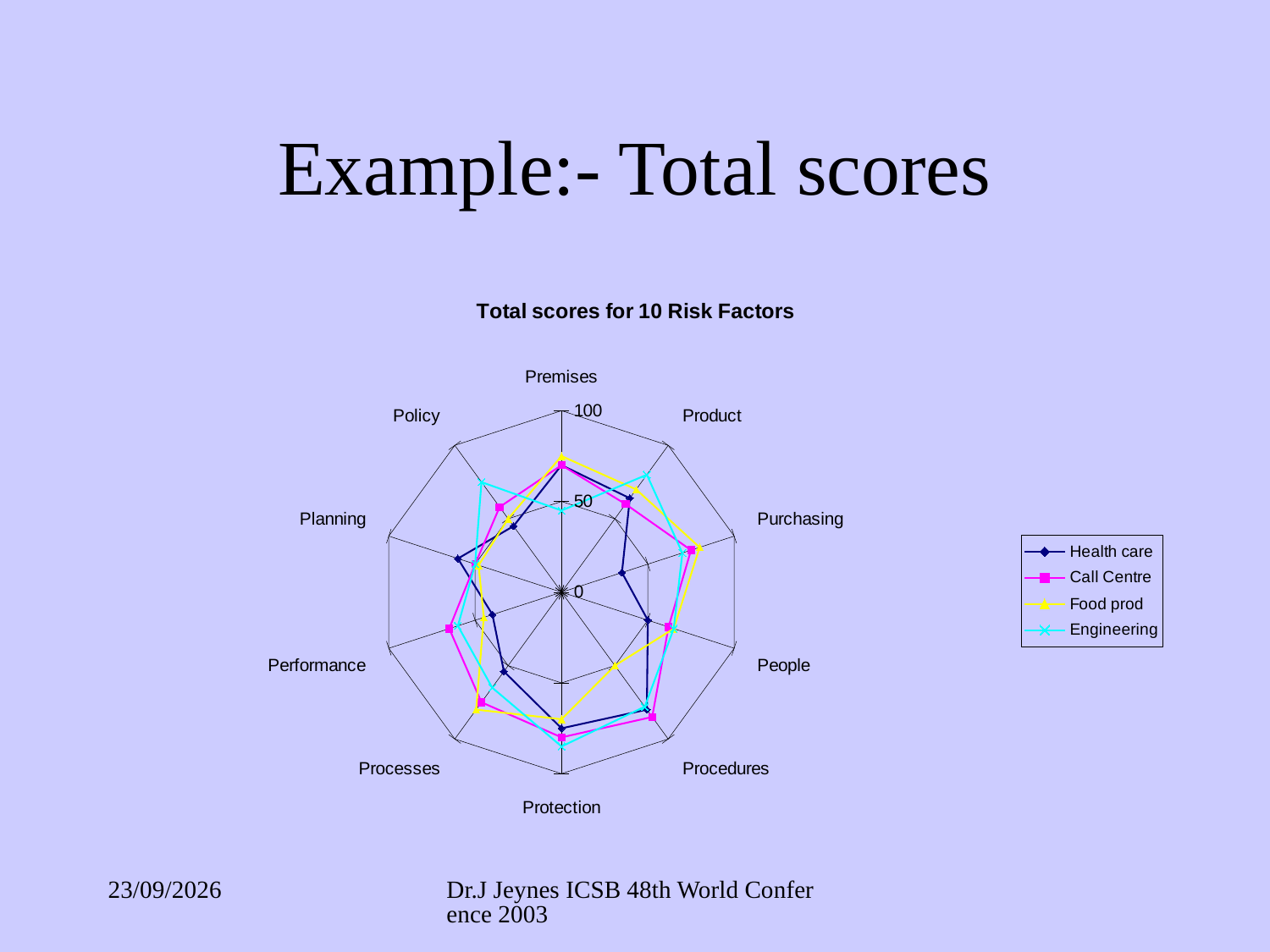
How many series does the legend list? 4 Is the Call Centre value for Purchasing greater or less than 50? greater Is the Health care value for Purchasing greater or less than 50? less For Purchasing, which series has the larger value, Engineering or Health care? Engineering What kind of chart is shown on the slide? Radar chart How many risk factor categories are plotted on the chart? 10 Which series is drawn in cyan with x markers? Engineering Is the Engineering value for Policy greater or less than 50? greater For Processes, which series has the larger value, Food prod or Health care? Food prod What is the title of the chart? Total scores for 10 Risk Factors For Premises, which series has the larger value, Health care or Engineering? Health care